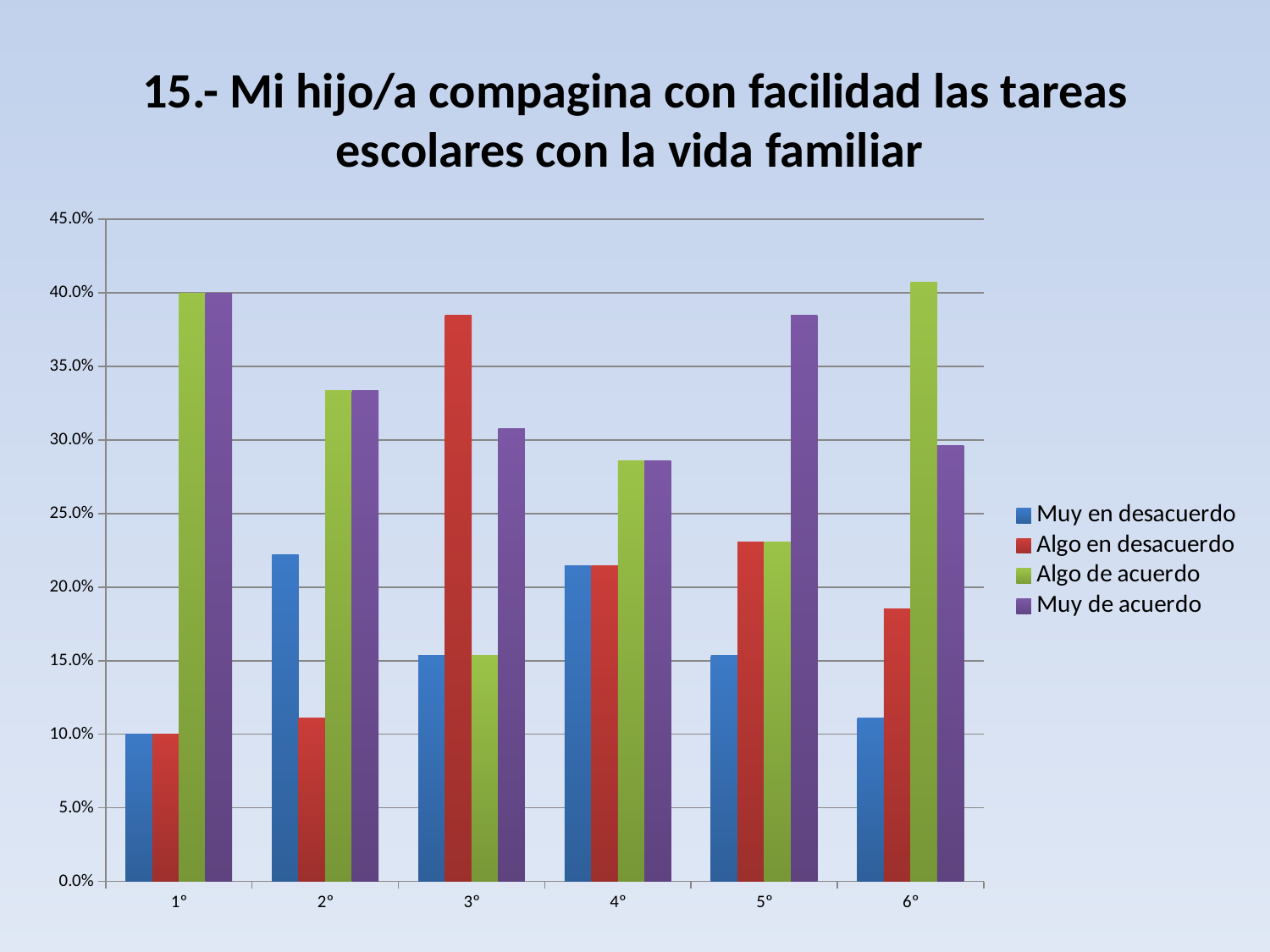
Which legend entry is shown in green? Algo de acuerdo Is the value for Muy en desacuerdo in category 2° greater or less than 20%? greater What kind of chart is shown on the slide? Bar chart In category 2°, which is larger: Muy en desacuerdo or Algo en desacuerdo? Muy en desacuerdo What is the value for Muy en desacuerdo in category 1°? 10.0% Is the value for Muy de acuerdo in category 4° greater or less than 30%? less How many series does the legend list? 4 Is the value for Algo en desacuerdo in category 3° greater or less than 35%? greater What is the value for Muy de acuerdo in category 1°? 40.0% Which series has the lowest value in category 6°? Muy en desacuerdo How many categories are shown on the x axis? 6 Which series has the highest value in category 3°? Algo en desacuerdo